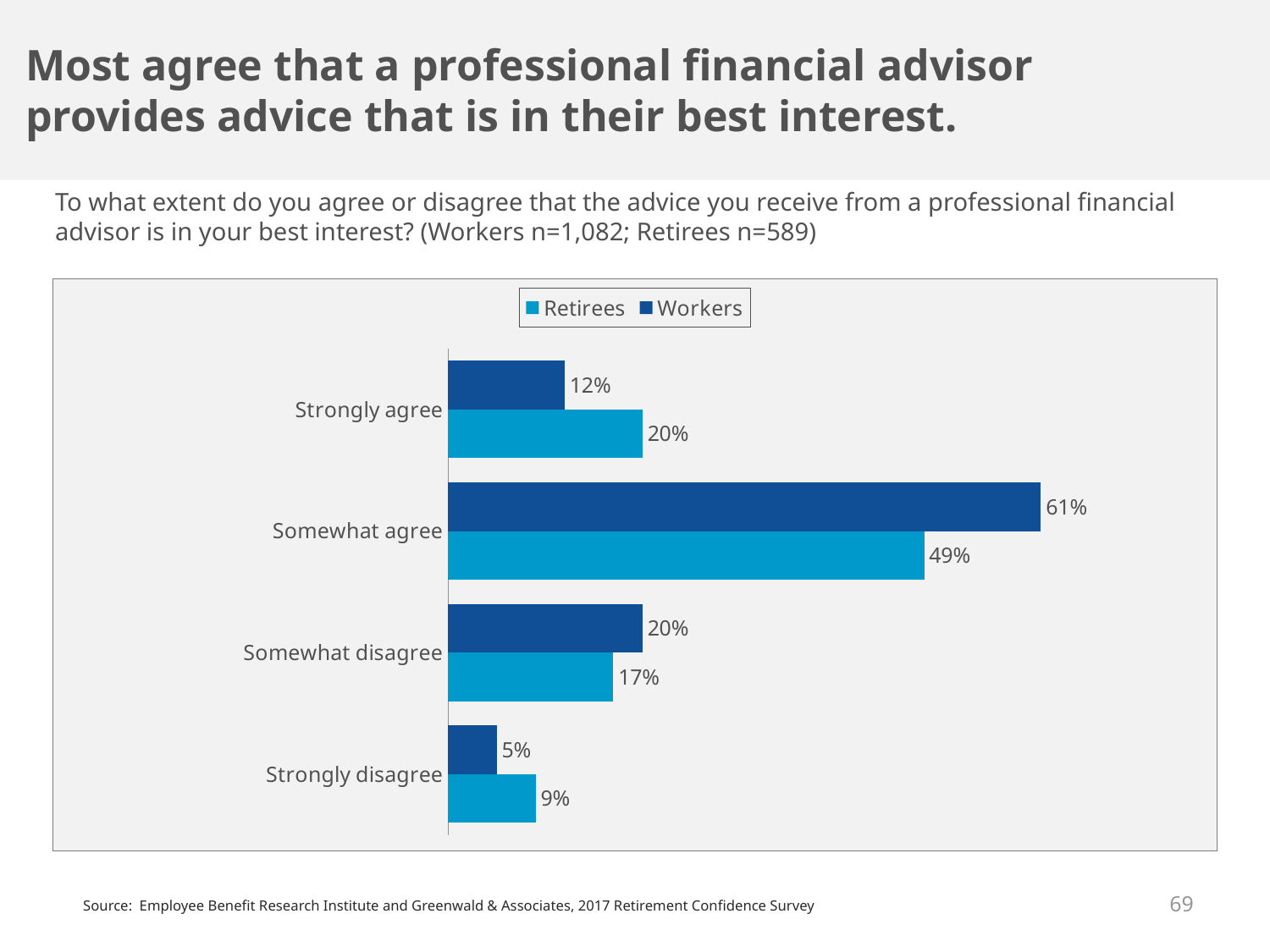
What is the value for Retirees in the Somewhat disagree category? 17% Which response category has the highest value for Workers? Somewhat agree What percentage of Retirees strongly agree? 20% Which response category has the lowest value for Retirees? Strongly disagree How many series does the legend list? 2 What type of chart is shown on the slide? Bar chart Which series is shown in the darker blue colour? Workers Which group has the larger value for Strongly agree, Retirees or Workers? Retirees What percentage of Workers somewhat agree that the advice they receive from a professional financial advisor is in their best interest? 61% What is the difference between the Workers and Retirees values for Somewhat agree? 12 percentage points What is the value for Workers in the Strongly disagree category? 5% How many response categories are shown on the chart? 4